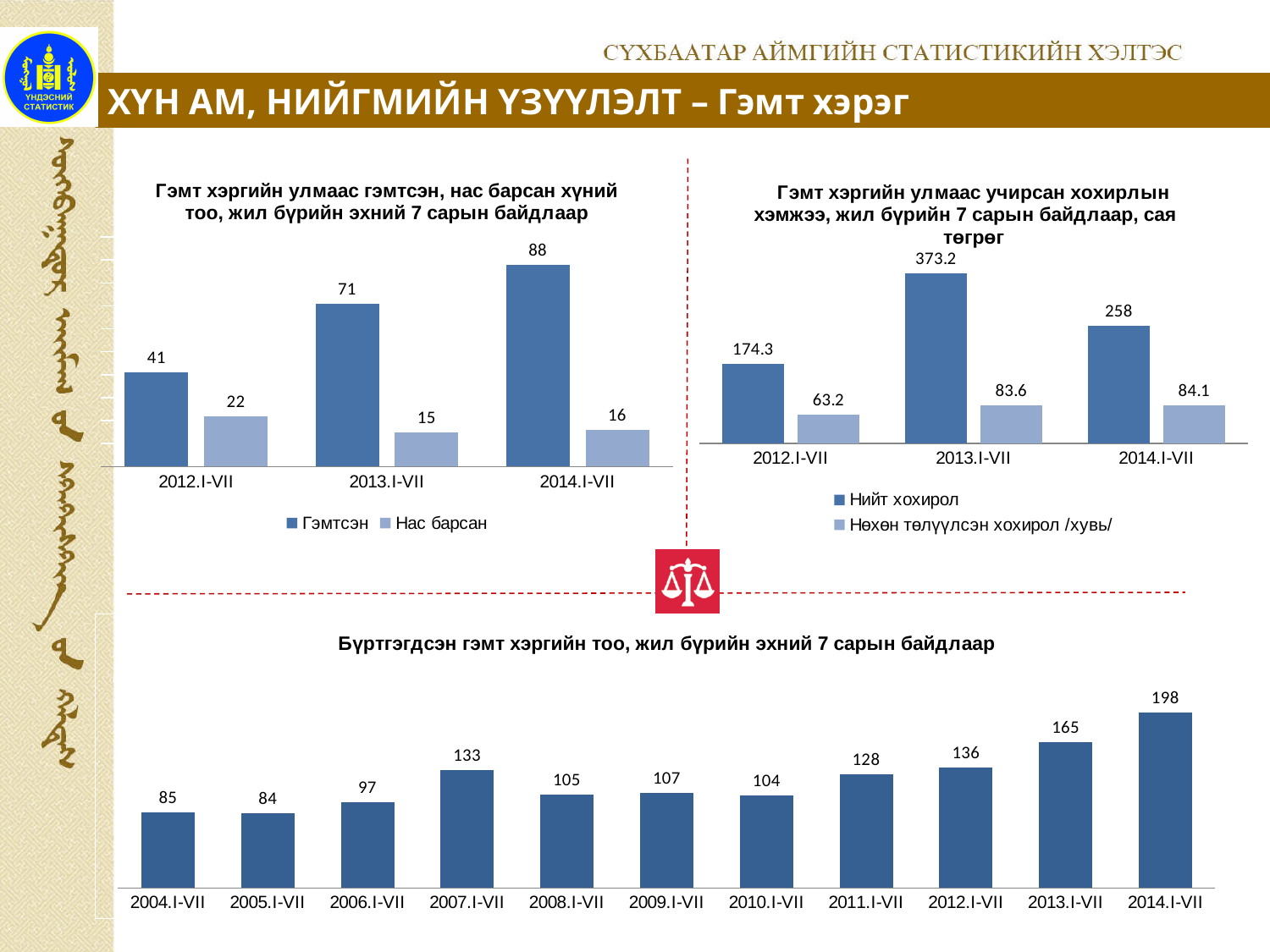
In the top-left chart 'Гэмт хэргийн улмаас гэмтсэн, нас барсан хүний тоо', how many series does the legend list? 2 In the bottom chart 'Бүртгэгдсэн гэмт хэргийн тоо', what is the difference between the values for 2014.I-VII and 2013.I-VII? 33 In the bottom chart 'Бүртгэгдсэн гэмт хэргийн тоо', how many periods are shown on the x axis? 11 In the top-left chart 'Гэмт хэргийн улмаас гэмтсэн, нас барсан хүний тоо', which period has the highest value for Нас барсан? 2012.I-VII In the bottom chart 'Бүртгэгдсэн гэмт хэргийн тоо', which period has the lowest value? 2005.I-VII In the bottom chart 'Бүртгэгдсэн гэмт хэргийн тоо', what is the value for 2014.I-VII? 198 In the top-right chart 'Гэмт хэргийн улмаас учирсан хохирлын хэмжээ', what kind of chart is it? Bar chart In the bottom chart 'Бүртгэгдсэн гэмт хэргийн тоо', which is larger: the value for 2007.I-VII or the value for 2011.I-VII? 2007.I-VII In the top-right chart 'Гэмт хэргийн улмаас учирсан хохирлын хэмжээ', what is the difference between Нийт хохирол for 2013.I-VII and 2012.I-VII? 198.9 In the top-left chart 'Гэмт хэргийн улмаас гэмтсэн, нас барсан хүний тоо', do the values for Гэмтсэн rise or fall from 2012.I-VII to 2014.I-VII? Rise In the top-left chart 'Гэмт хэргийн улмаас гэмтсэн, нас барсан хүний тоо', what is the value of Гэмтсэн for 2013.I-VII? 71 In the top-right chart 'Гэмт хэргийн улмаас учирсан хохирлын хэмжээ', what is the value of Нийт хохирол for 2013.I-VII? 373.2